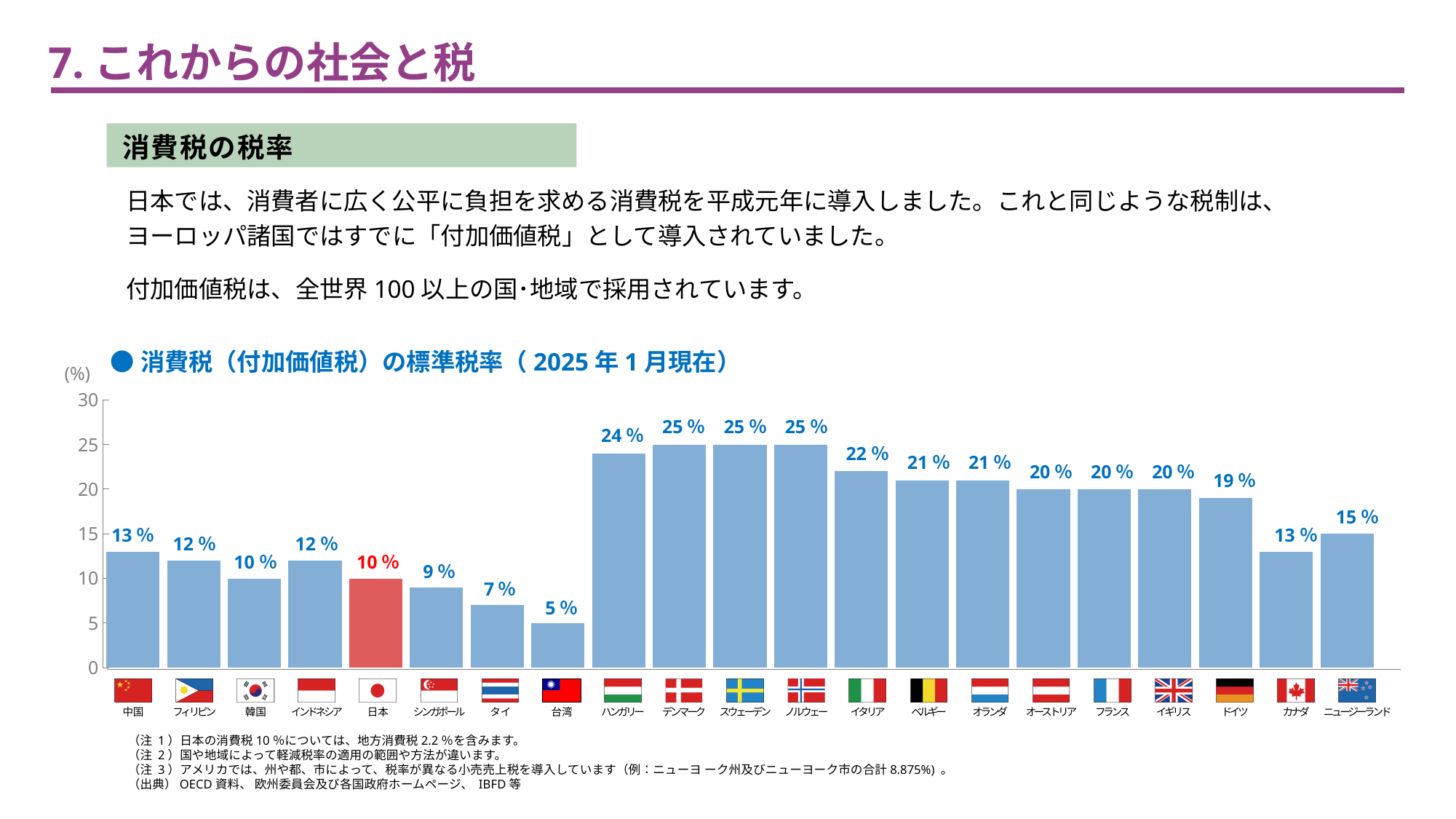
グラフで日本の消費税（付加価値税）の標準税率はいくらですか？ 10 % グラフでイタリアとドイツでは、どちらの標準税率が高いですか？ イタリア グラフでデンマークと日本の標準税率の差は何ポイントですか？ 15 % グラフでニュージーランドの標準税率はいくらですか？ 15 % グラフのタイトルに示されている基準時点はいつですか？ 2025 年 1 月現在 グラフで標準税率が最も低い国・地域はどこですか？ 台湾 グラフには何か国・地域の棒が表示されていますか？ 21 このグラフはどの種類のグラフですか？ 棒グラフ グラフでハンガリーの標準税率はいくらですか？ 24 % グラフでシンガポールとタイでは、どちらの標準税率が低いですか？ タイ グラフで標準税率が25 %の国はいくつありますか？ 3 グラフで赤色で強調されている棒はどの国のものですか？ 日本